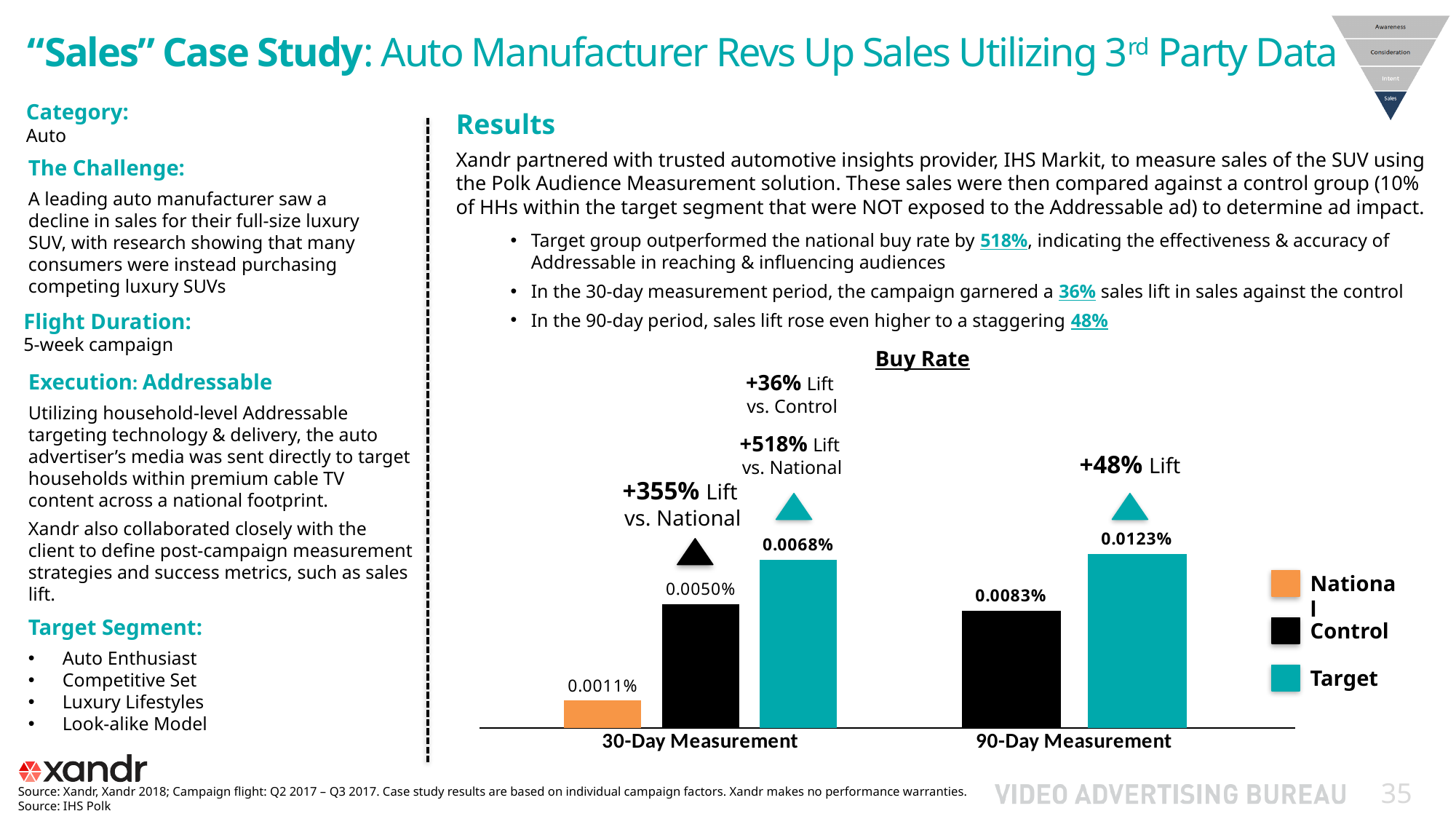
What is the difference between the Target and Control buy rates in the 90-Day Measurement? 0.0040% How many series does the chart legend list? 3 In the 30-Day Measurement, which is larger: the Control buy rate or the Target buy rate? Target What is the National buy rate for the 30-Day Measurement? 0.0011% Which colour represents the Target series in the chart legend? teal What is the Target buy rate for the 30-Day Measurement? 0.0068% What type of chart is shown under the Buy Rate title? bar chart What is the Control buy rate for the 90-Day Measurement? 0.0083% What is the title of the chart? Buy Rate Which bar in the chart has the highest buy rate? Target, 90-Day Measurement Which bar in the chart has the lowest buy rate? National, 30-Day Measurement What is the Target buy rate for the 90-Day Measurement? 0.0123%